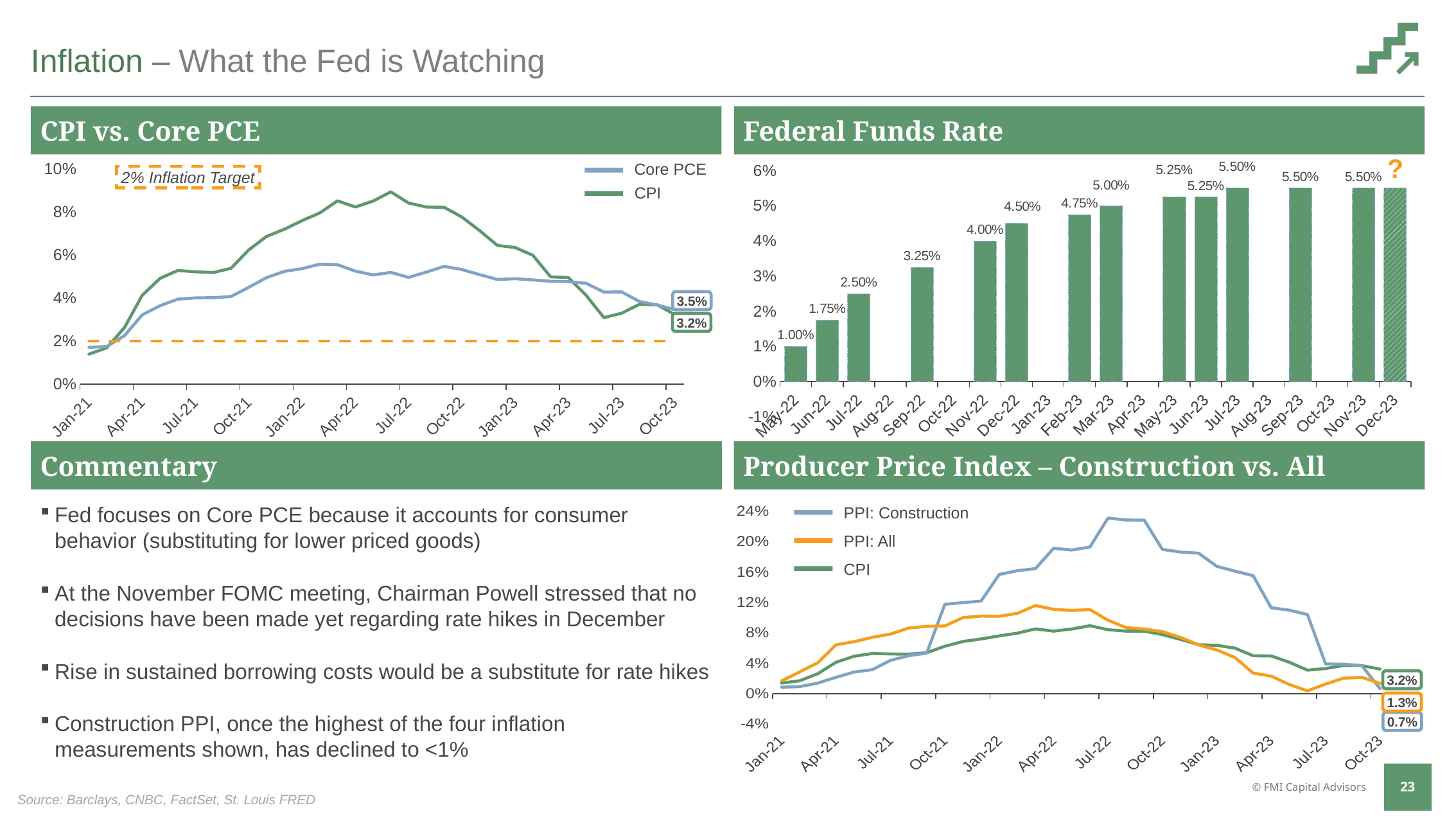
How many series does the legend of the CPI vs. Core PCE chart list? 2 In the Federal Funds Rate chart, what is the value for Dec-22? 4.50% In the Federal Funds Rate chart, which month has the lowest value? May-22 What kind of chart is the Federal Funds Rate chart? bar chart In the Federal Funds Rate chart, what is the difference between the Mar-23 and Feb-23 values? 0.25% In the Federal Funds Rate chart, what is the value for Jul-22? 2.50% In the Federal Funds Rate chart, which is larger, the value for Nov-22 or Dec-22? Dec-22 What kind of chart is the CPI vs. Core PCE chart? line chart In the Producer Price Index – Construction vs. All chart, what is the latest labelled value for PPI: Construction? 0.7% In the Federal Funds Rate chart, do the values generally rise or fall from May-22 to Nov-23? rise In the CPI vs. Core PCE chart, what is the latest labelled value for Core PCE? 3.5% How many series does the legend of the Producer Price Index – Construction vs. All chart list? 3